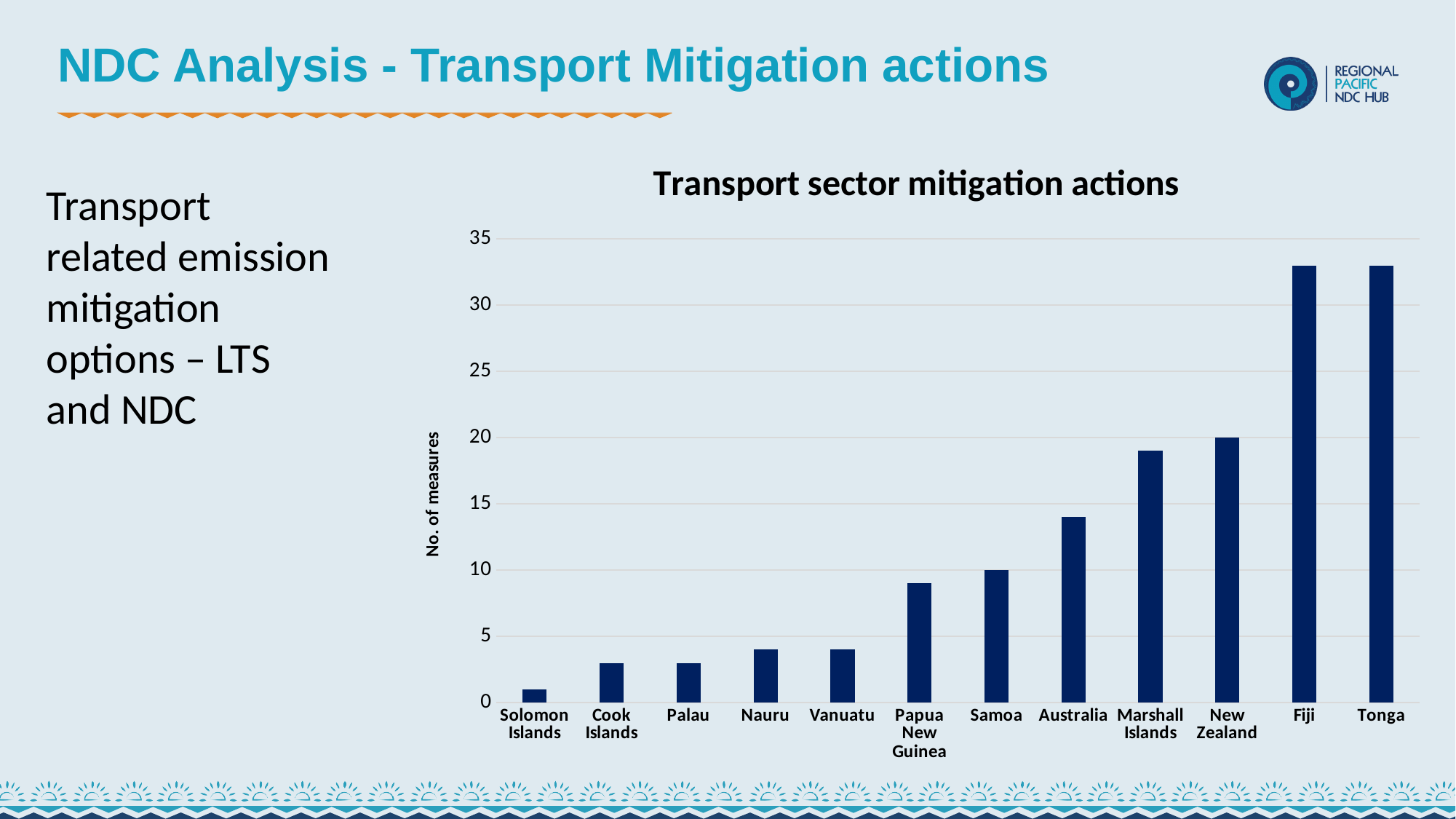
Which country has the lowest number of transport sector mitigation measures? Solomon Islands What type of chart is shown on the slide? Bar chart How many measures does Samoa have in the chart? 10 Which has more measures, Australia or Samoa? Australia How many countries are shown on the x axis of the chart? 12 What is the title of the chart? Transport sector mitigation actions What is the label on the vertical axis of the chart? No. of measures Is the value for Fiji greater or less than 30? greater Is the value for Papua New Guinea greater or less than 10? less How many measures does New Zealand have in the chart? 20 Do the values generally rise or fall moving from left to right along the x axis? Rise Is the value for Australia greater or less than 15? less